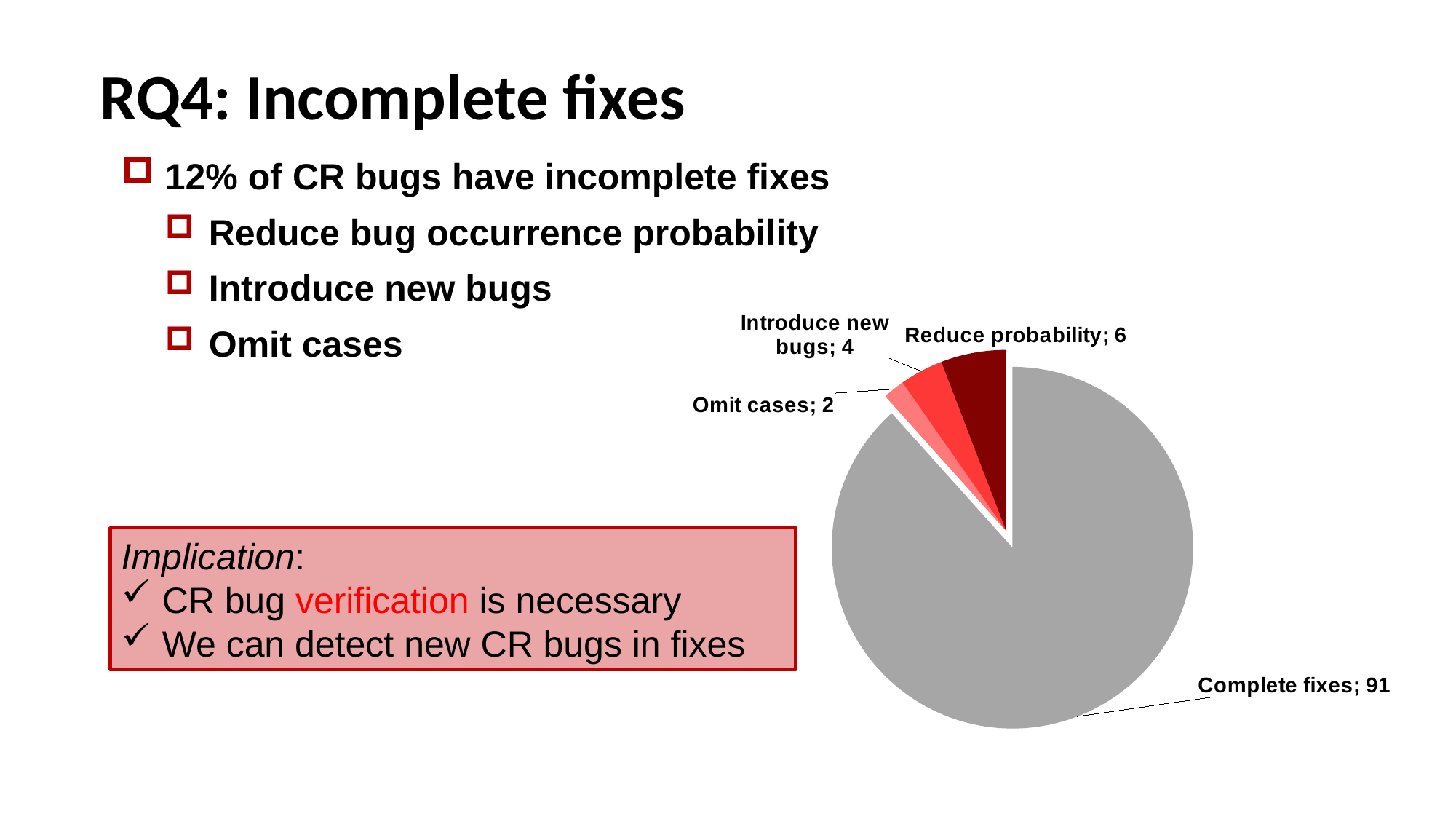
What is the value for Reduce probability in the pie chart? 6 What is the value for Introduce new bugs in the pie chart? 4 Which slice of the pie chart is the smallest? Omit cases What is the difference between the values for Reduce probability and Omit cases? 4 What is the value for Omit cases in the pie chart? 2 How many slices does the pie chart have? 4 What colour is the Complete fixes slice of the pie chart? grey What is the value for Complete fixes in the pie chart? 91 Which is larger, the value for Introduce new bugs or the value for Omit cases? Introduce new bugs Which slice of the pie chart is the largest? Complete fixes What is the total of all the values shown in the pie chart? 103 What kind of chart is shown on the slide? pie chart